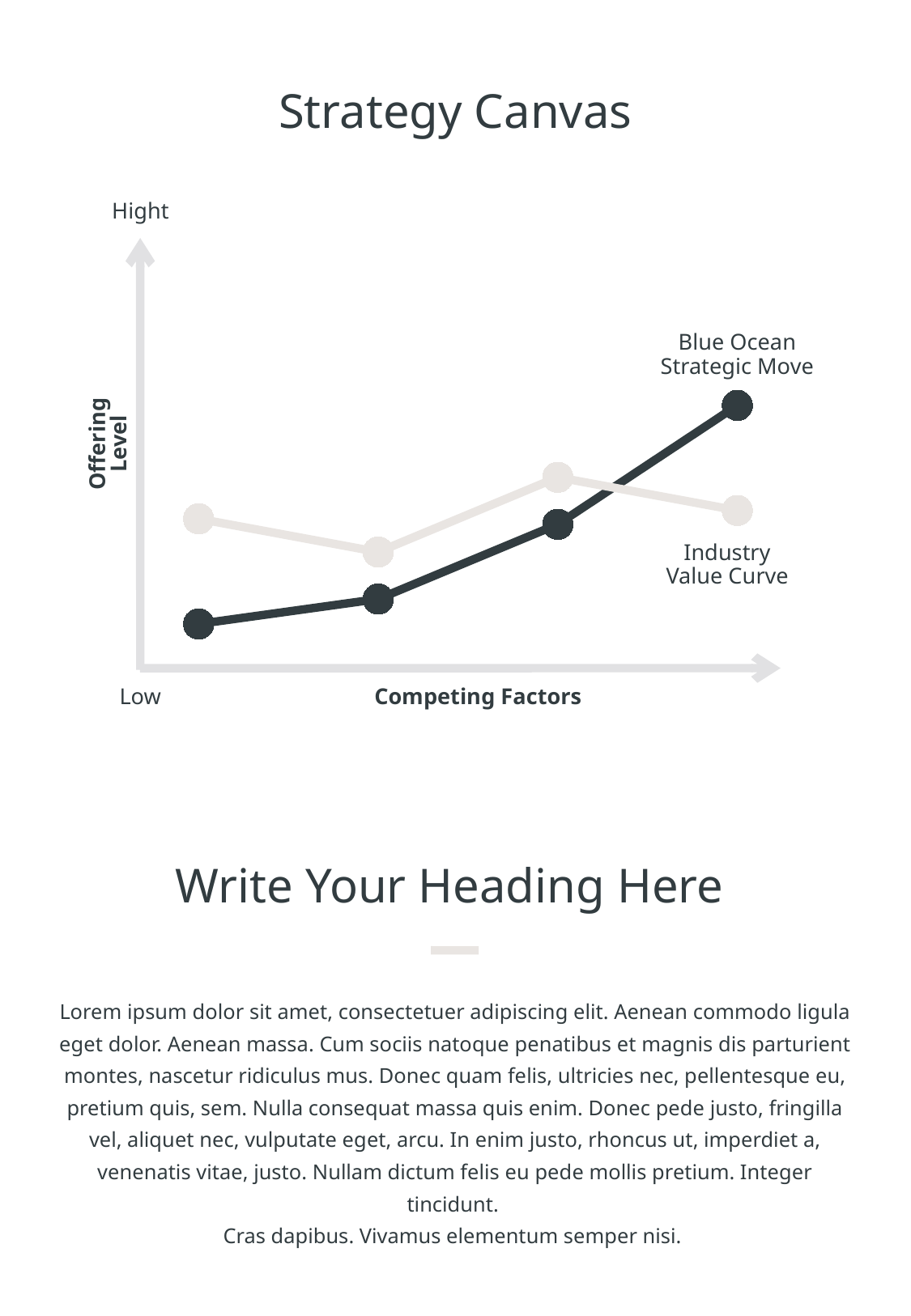
At the leftmost competing factor, which curve is higher: Blue Ocean Strategic Move or Industry Value Curve? Industry Value Curve Which curve reaches the highest point on the chart? Blue Ocean Strategic Move Does the Blue Ocean Strategic Move curve rise or fall from left to right? Rise What is the label of the horizontal axis? Competing Factors How many data points does the Industry Value Curve have? 4 Which curve has the lowest point on the chart? Blue Ocean Strategic Move What is the title of the chart? Strategy Canvas What kind of chart is shown on the slide? Line chart How many data points does the Blue Ocean Strategic Move curve have? 4 How many series (curves) are plotted on the chart? 2 At the rightmost competing factor, which curve is higher: Blue Ocean Strategic Move or Industry Value Curve? Blue Ocean Strategic Move